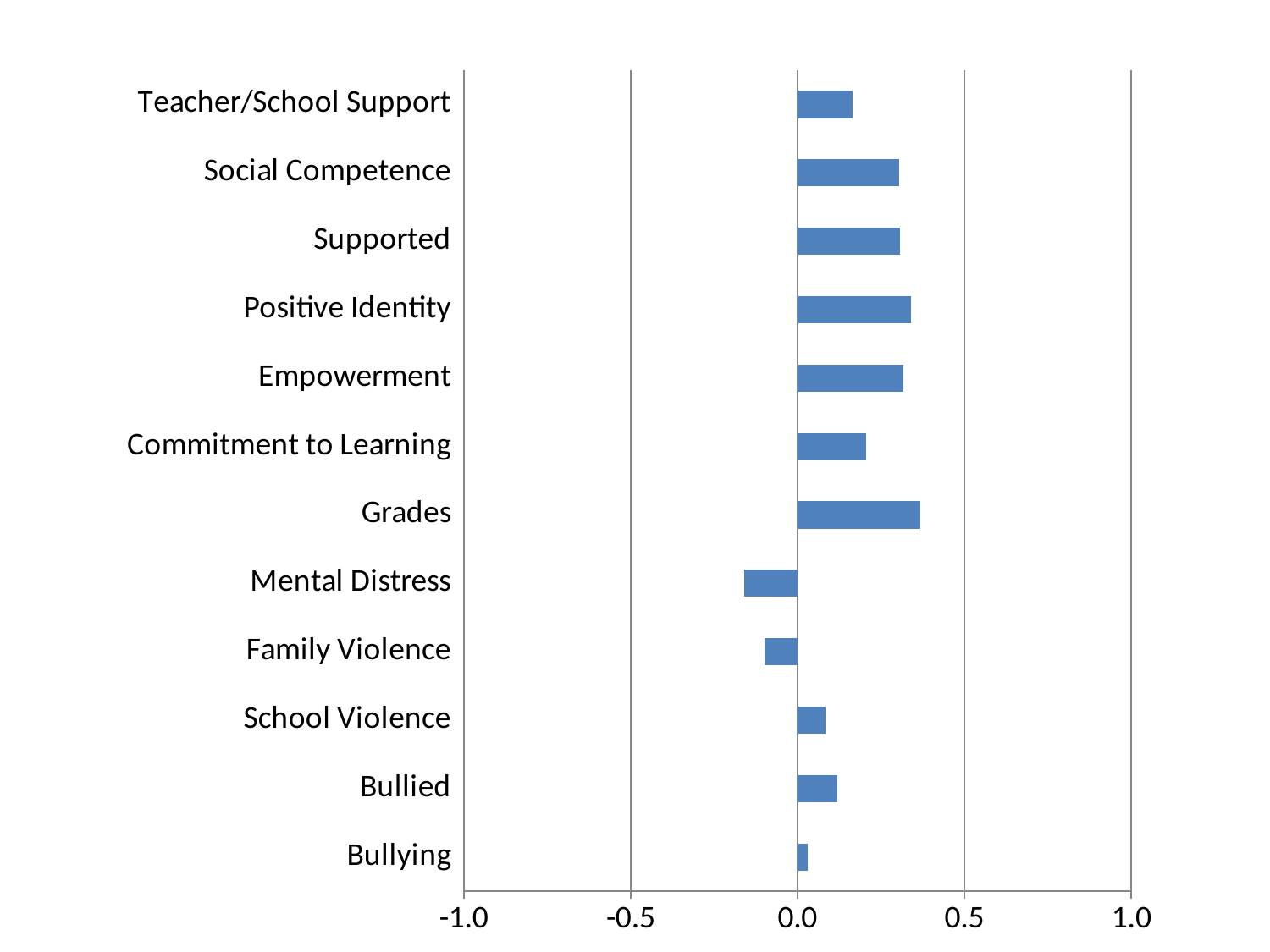
Is the value for Family Violence greater or less than 0.0? less How many categories in the chart have negative values? 2 What kind of chart is shown on the slide? bar chart Which is larger, the value for Grades or the value for Teacher/School Support? Grades What is the lowest value shown on the horizontal axis? -1.0 Is the value for Social Competence greater or less than 0.0? greater Is the value for Grades greater or less than 0.5? less How many categories are plotted in the chart? 12 Which is larger, the value for Bullied or the value for Bullying? Bullied Which category has the lowest value in the chart? Mental Distress Which is larger, the value for Positive Identity or the value for Commitment to Learning? Positive Identity